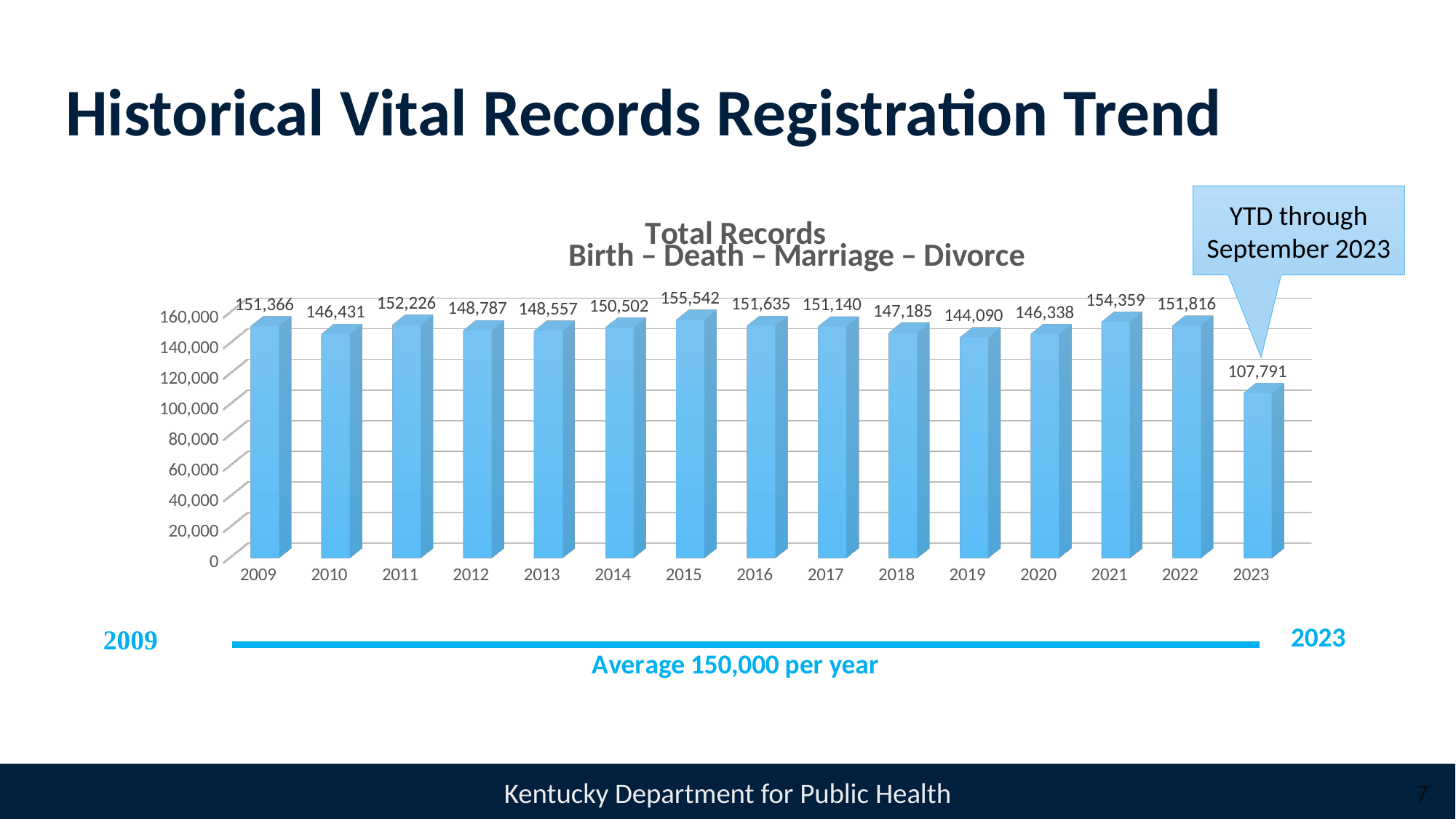
What is the total records value for 2019? 144,090 What kind of chart is shown on the slide? bar chart How many years are shown on the chart? 15 Which year has the lowest total records? 2023 What is the total records value for 2023? 107,791 What is the difference between the total records for 2021 and 2020? 8,021 What period does the 2023 bar cover, according to the callout? YTD through September 2023 Is the value for 2023 greater or less than 120,000? less What is the total records value for 2015? 155,542 Which year has the highest total records? 2015 Which year has more total records, 2011 or 2010? 2011 What is the difference between the total records for 2022 and 2023? 44,025